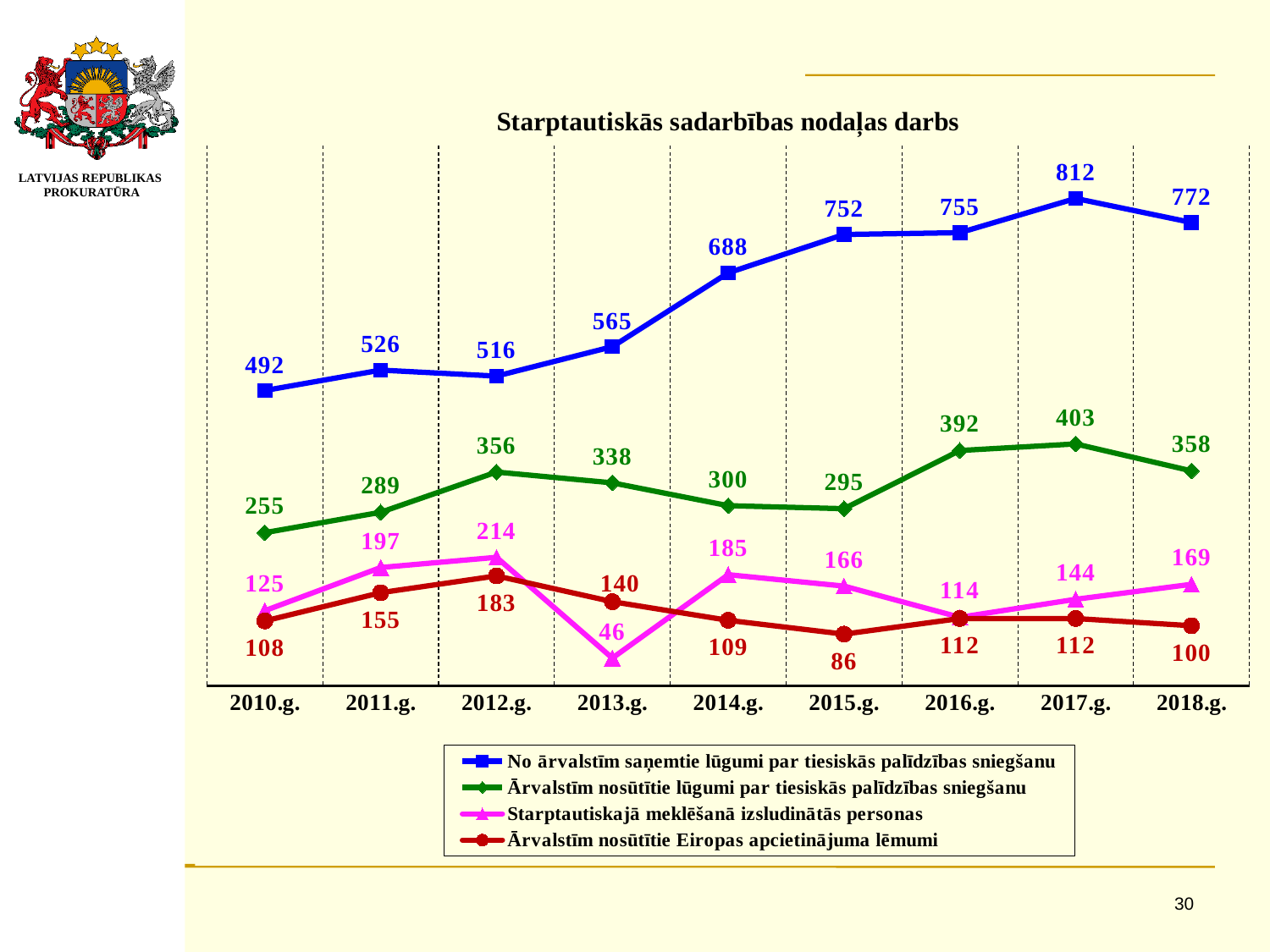
How many years are shown on the x axis? 9 What is the value for 'Ārvalstīm nosūtītie Eiropas apcietinājuma lēmumi' in 2015.g.? 86 Does 'No ārvalstīm saņemtie lūgumi par tiesiskās palīdzības sniegšanu' rise or fall from 2010.g. to 2017.g.? rise What type of chart is shown on the slide? line chart Which is larger in 2012.g.: 'Starptautiskajā meklēšanā izsludinātās personas' or 'Ārvalstīm nosūtītie Eiropas apcietinājuma lēmumi'? Starptautiskajā meklēšanā izsludinātās personas What is the title of the chart? Starptautiskās sadarbības nodaļas darbs What is the value for 'Starptautiskajā meklēšanā izsludinātās personas' in 2013.g.? 46 In which year is 'Ārvalstīm nosūtītie lūgumi par tiesiskās palīdzības sniegšanu' lowest? 2010.g. What is the difference between the 2017.g. and 2018.g. values for 'No ārvalstīm saņemtie lūgumi par tiesiskās palīdzības sniegšanu'? 40 In which year is 'No ārvalstīm saņemtie lūgumi par tiesiskās palīdzības sniegšanu' highest? 2017.g. What is the value for 'No ārvalstīm saņemtie lūgumi par tiesiskās palīdzības sniegšanu' in 2014.g.? 688 How many series does the legend list? 4